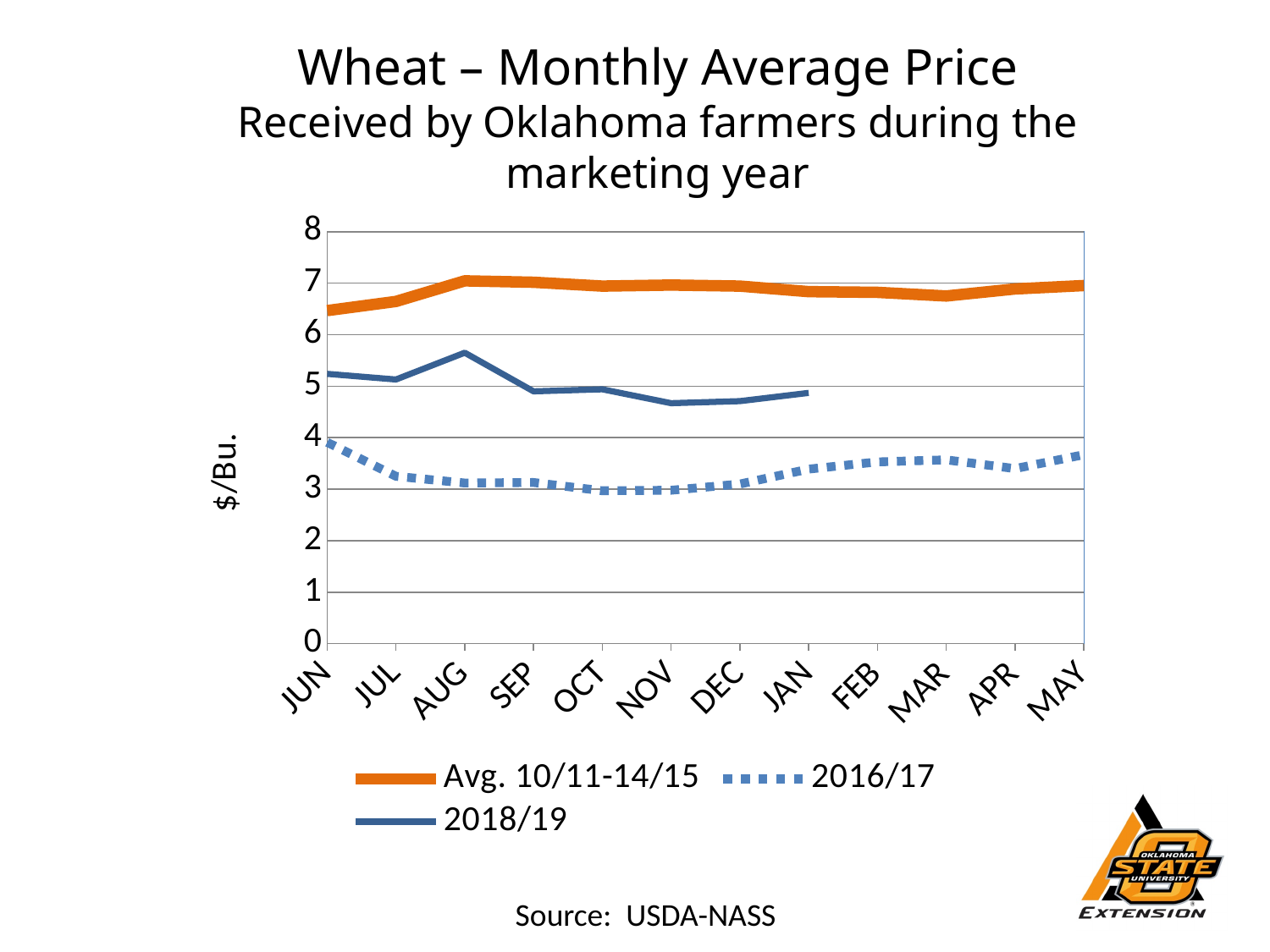
How many series does the legend list? 3 In which month does the 2016/17 series reach its highest value? JUN Is the 2018/19 value for AUG greater or less than 5? greater What type of chart is shown on the slide? line chart In which month does the 2018/19 series reach its highest value? AUG In JUN, which series has the higher value, 2016/17 or 2018/19? 2018/19 Is the 2018/19 value for NOV greater or less than 5? less Is the 2016/17 value for OCT greater or less than 4? less How many months does the 2018/19 line cover? 8 How many months are shown along the x axis? 12 In JAN, which series is higher, Avg. 10/11-14/15 or 2018/19? Avg. 10/11-14/15